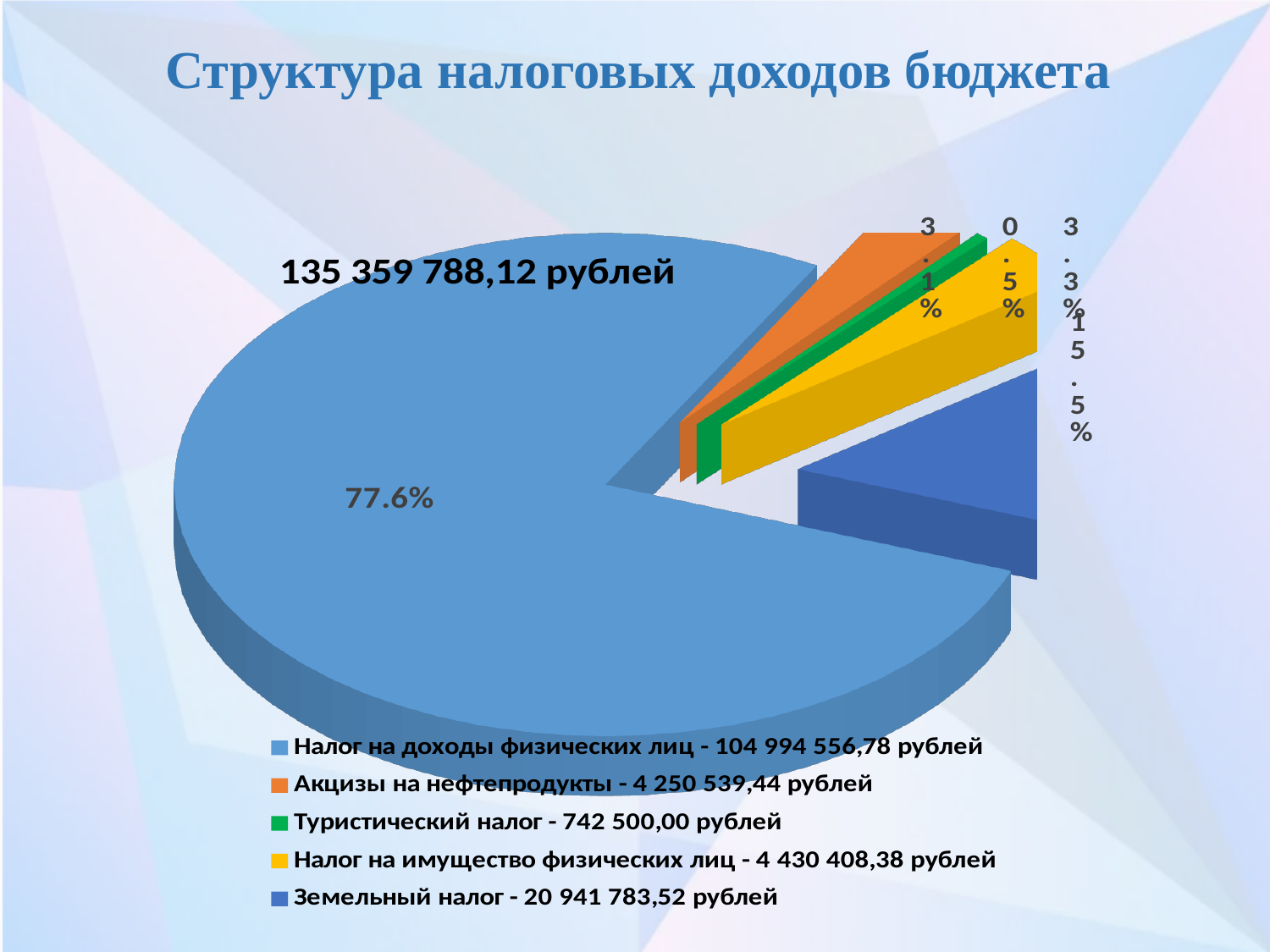
Which category has the smallest slice of the pie? Туристический налог What share of the pie does Туристический налог take? 0.5% What share of the pie does Земельный налог take? 15.5% What is the title of the chart? 135 359 788,12 рублей What kind of chart is shown on the slide? pie chart What amount in rubles does the legend give for Налог на имущество физических лиц? 4 430 408,38 рублей Which is larger: the share for Акцизы на нефтепродукты or the share for Земельный налог? Земельный налог What share of the pie does Налог на доходы физических лиц take? 77.6% What is the difference in percentage points between the share for Налог на доходы физических лиц and the share for Земельный налог? 62.1% How many entries does the legend list? 5 Which category has the largest slice of the pie? Налог на доходы физических лиц How many slices does the pie chart have? 5